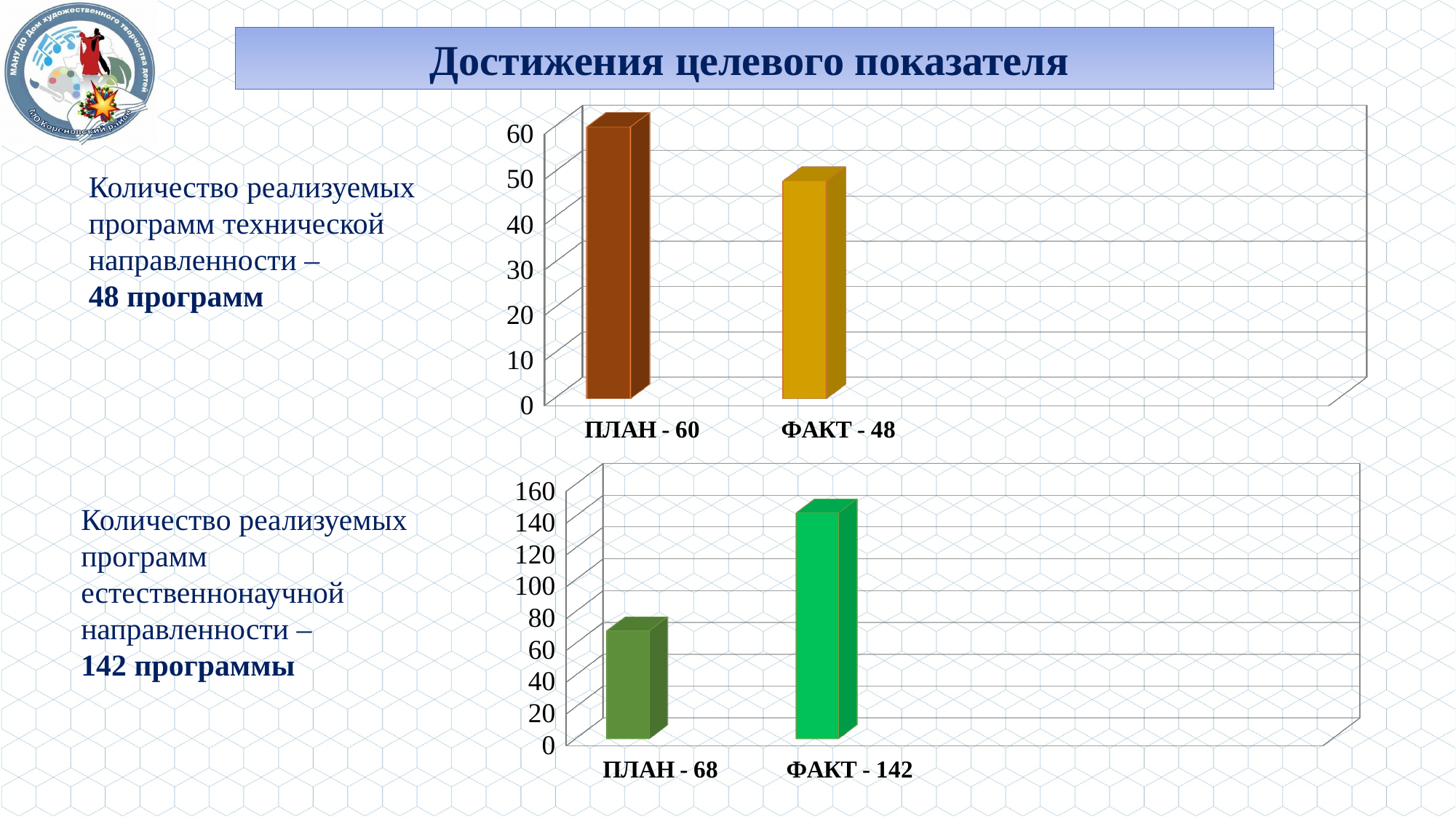
On the bottom chart, what is the difference between the ФАКТ and ПЛАН values? 74 What kind of chart is the bottom chart? bar chart On the top chart, which category has the higher value? ПЛАН - 60 On the bottom chart, what is the value for ПЛАН? 68 On the top chart, how many bars are plotted? 2 On the top chart, what is the value for ФАКТ? 48 On the bottom chart, which category has the lower value? ПЛАН - 68 On the bottom chart, is the value for ФАКТ greater or less than 100? greater What is the title shown at the top of the slide? Достижения целевого показателя On the bottom chart, what is the value for ФАКТ? 142 On the top chart, what is the value for ПЛАН? 60 On the top chart, what is the difference between the ПЛАН and ФАКТ values? 12